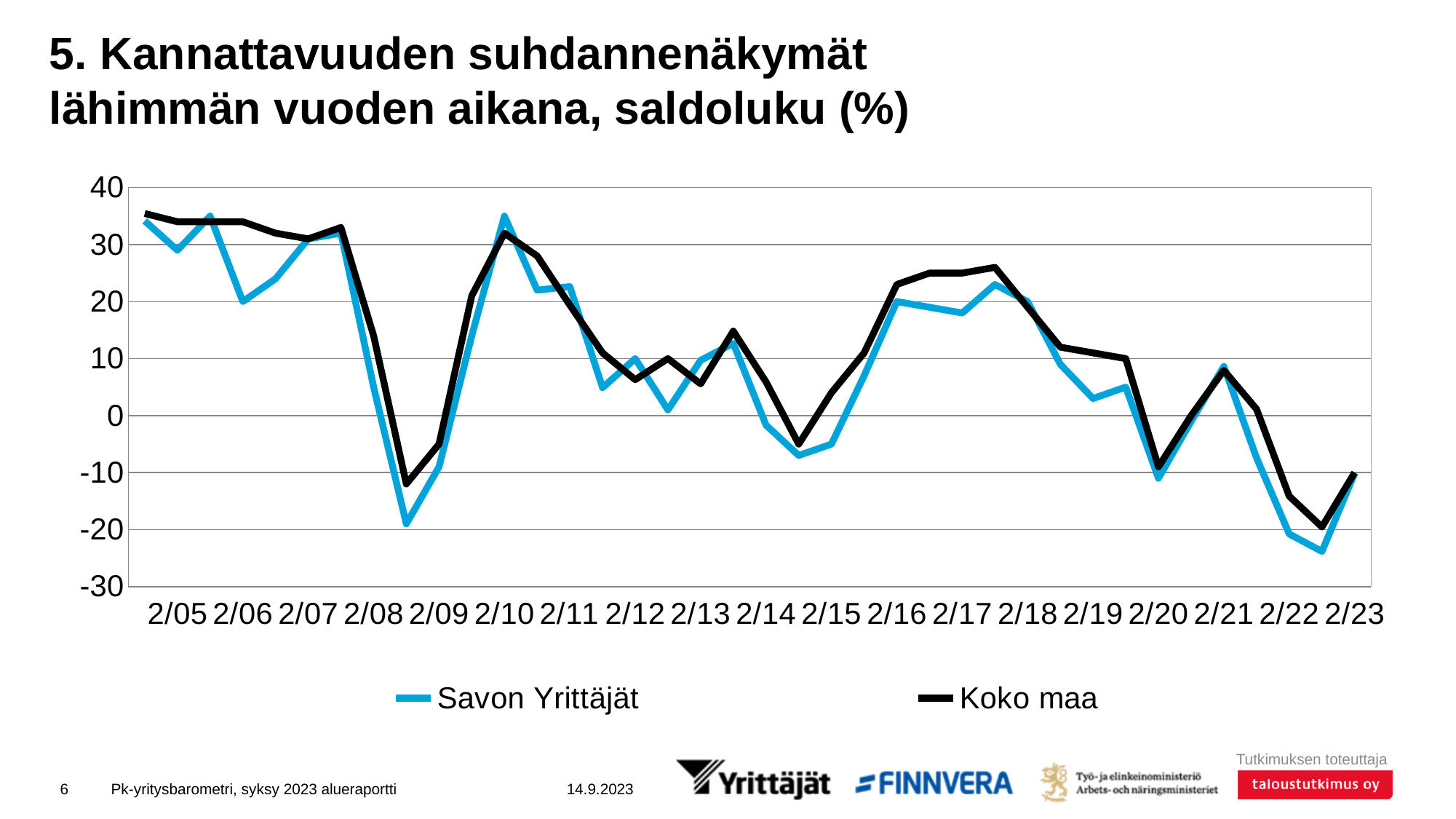
Is the value for Savon Yrittäjät at 2/23 greater or less than 0? less What kind of chart is shown on the slide? line chart Which two series are listed in the legend? Savon Yrittäjät and Koko maa Is the value for Koko maa at 2/22 greater or less than -10? less How many labelled categories are shown on the x axis? 19 How many series does the legend list? 2 Is the value for Koko maa at 2/05 greater or less than 30? greater At 2/22, which series has the higher value, Savon Yrittäjät or Koko maa? Koko maa Overall, do the values for Koko maa rise or fall from 2/05 to 2/23? fall At 2/19, which series has the higher value, Savon Yrittäjät or Koko maa? Koko maa Which series is drawn in blue? Savon Yrittäjät